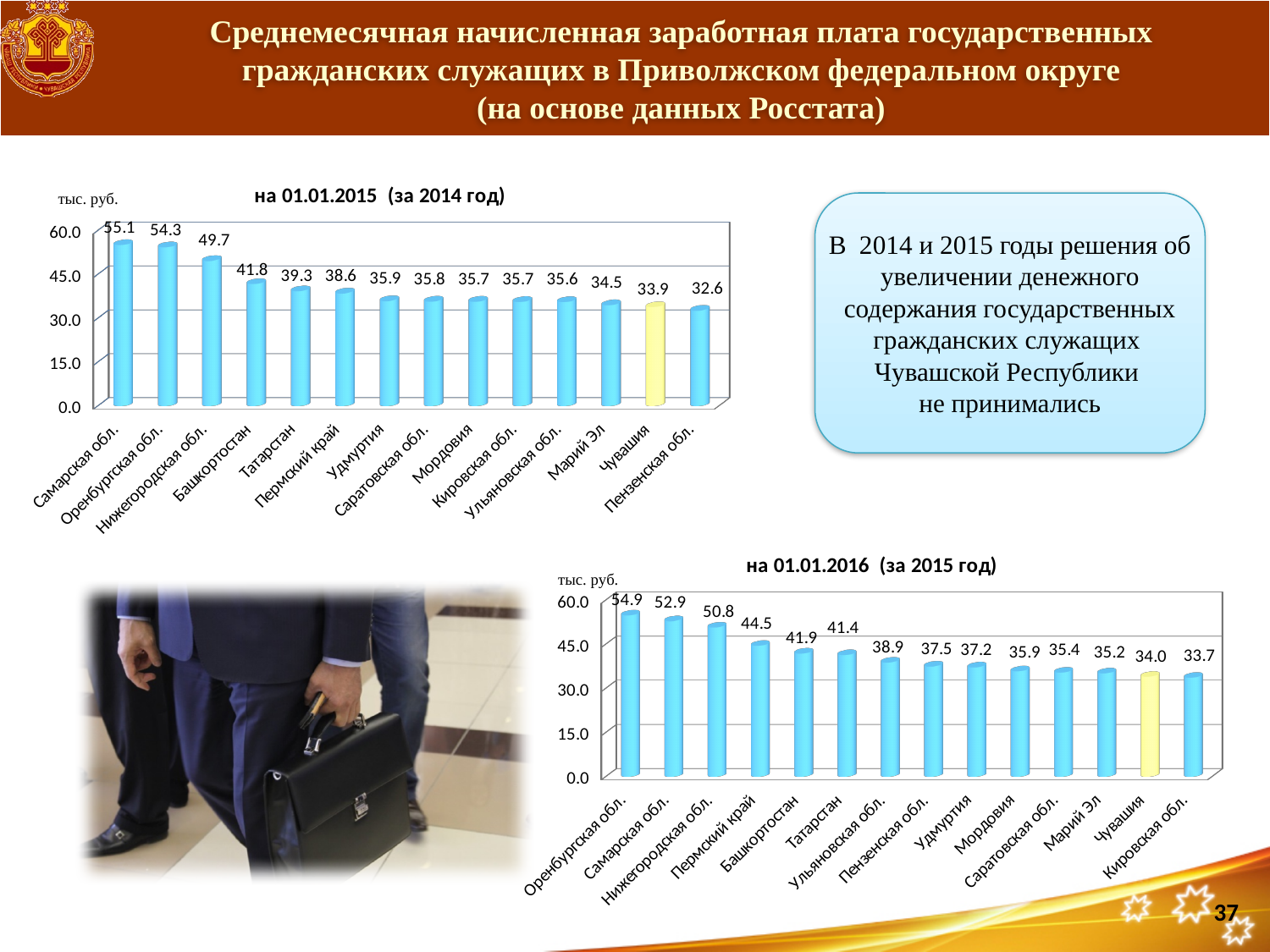
In the chart 'на 01.01.2015 (за 2014 год)', how many regions are shown? 14 In the chart 'на 01.01.2015 (за 2014 год)', which region has the highest value? Самарская обл. In the chart 'на 01.01.2016 (за 2015 год)', which region has the highest value? Оренбургская обл. In the chart 'на 01.01.2016 (за 2015 год)', what is the difference between the values for Оренбургская обл. and Чувашия? 20.9 In the chart 'на 01.01.2015 (за 2014 год)', which region has the lowest value? Пензенская обл. In the chart 'на 01.01.2015 (за 2014 год)', what is the difference between the values for Самарская обл. and Чувашия? 21.2 In the chart 'на 01.01.2015 (за 2014 год)', do the values rise or fall from left to right? fall In the chart 'на 01.01.2016 (за 2015 год)', which is larger, the value for Татарстан or the value for Ульяновская обл.? Татарстан In the chart 'на 01.01.2016 (за 2015 год)', what is the value for Пермский край? 44.5 What type of chart is the chart 'на 01.01.2016 (за 2015 год)'? bar chart In the chart 'на 01.01.2015 (за 2014 год)', what is the value for Чувашия? 33.9 In the chart 'на 01.01.2016 (за 2015 год)', which region has the lowest value? Кировская обл.